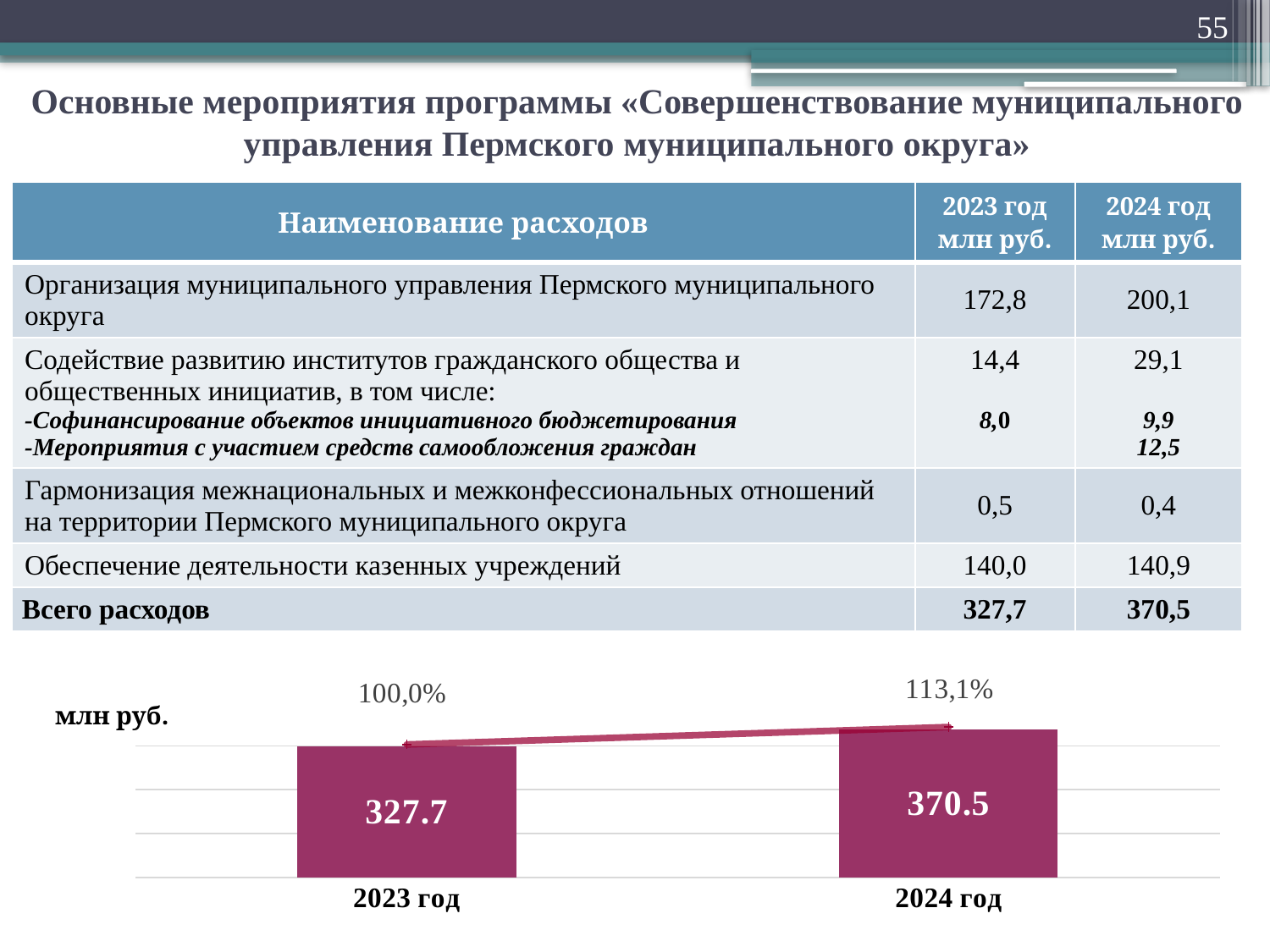
How many bars are plotted in the chart? 2 What is the value shown for 2024 год in the bar chart? 370.5 What percentage label is shown above the 2024 год bar? 113,1% What percentage label is shown above the 2023 год bar? 100,0% What unit is indicated next to the bar chart? млн руб. Do the values in the bar chart rise or fall from 2023 год to 2024 год? rise Is the value for 2024 год larger or smaller than the value for 2023 год in the bar chart? larger What is the value shown for 2023 год in the bar chart? 327.7 Which year has the higher bar in the chart? 2024 год Which year has the lower bar in the chart? 2023 год What kind of chart is shown at the bottom of the slide? bar chart What is the difference between the 2024 год and 2023 год values in the bar chart? 42.8